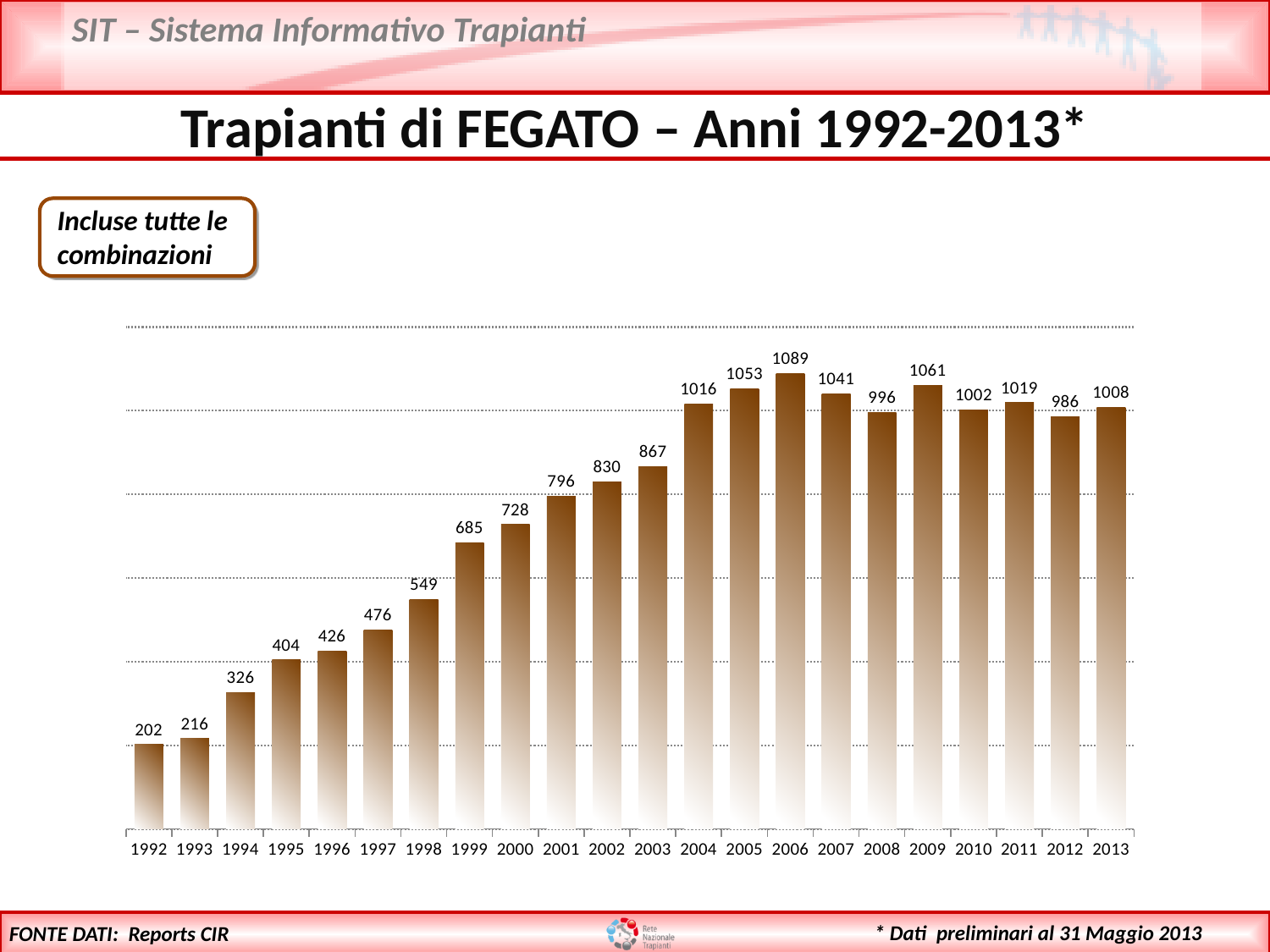
Which is larger, the value for 2009 or the value for 2010? 2009 What is the value for 2006? 1089 How many years are shown on the x axis? 22 Do the values rise or fall from 1992 to 2006? rise Which year has the lowest value? 1992 What is the value for 2013? 1008 What is the value for 1992? 202 Which year has the highest value? 2006 What is the value for 1999? 685 What is the difference between the values for 2013 and 2012? 22 What is the difference between the values for 2006 and 1992? 887 What kind of chart is shown on the slide? bar chart